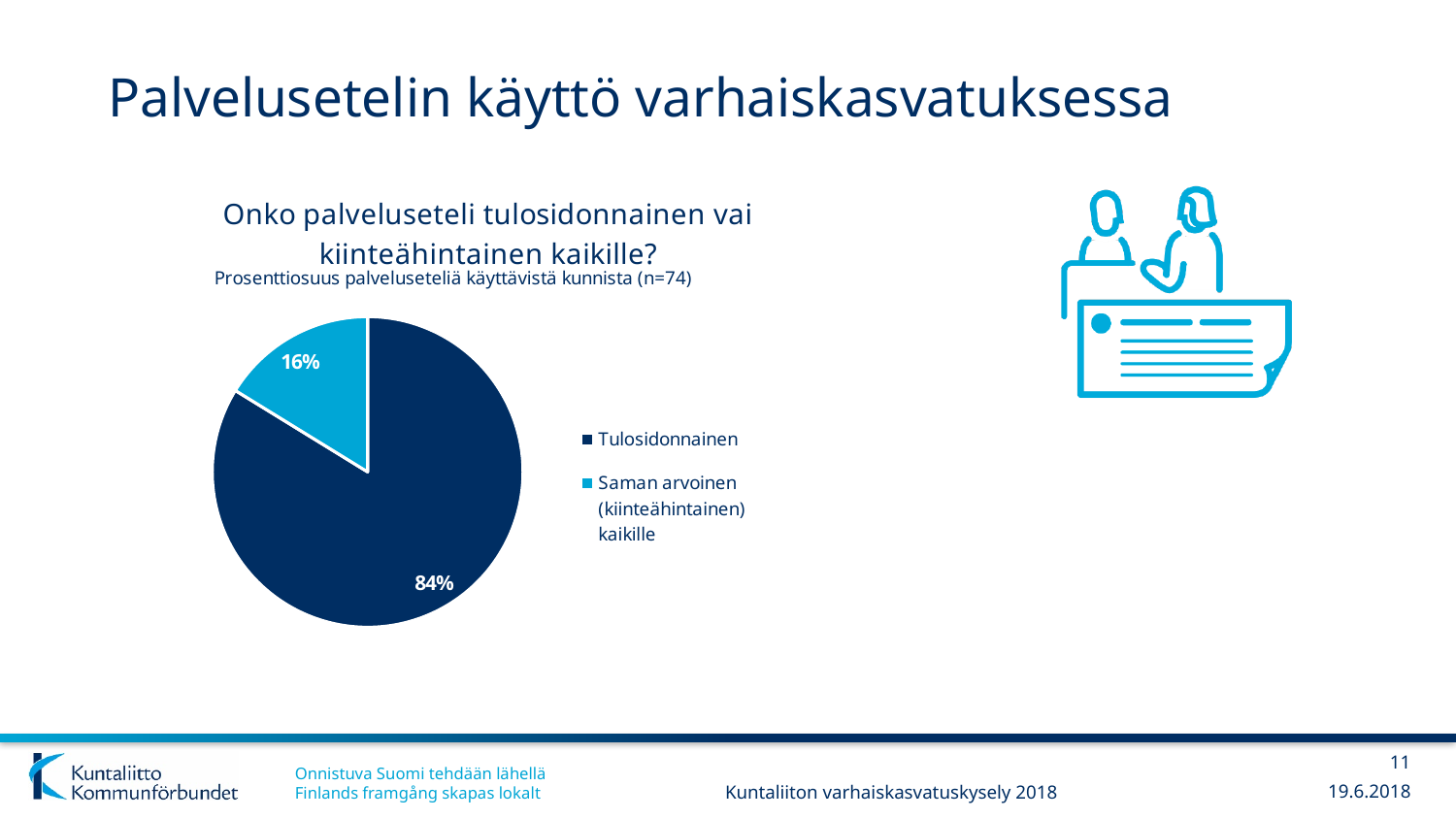
What percentage of the pie is labelled Tulosidonnainen? 84% How many municipalities (n) does the chart subtitle say the percentages are based on? 74 What kind of chart is shown on the slide? Pie chart How many entries does the legend list? 2 What percentage of the pie is labelled Saman arvoinen (kiinteähintainen) kaikille? 16% What is the difference in percentage points between the Tulosidonnainen slice and the Saman arvoinen (kiinteähintainen) kaikille slice? 68 percentage points Which is larger: the Tulosidonnainen slice or the Saman arvoinen (kiinteähintainen) kaikille slice? Tulosidonnainen Which category has the largest share of the pie? Tulosidonnainen How many slices does the pie chart have? 2 What is the total of the two percentages shown on the pie chart? 100% What is the title of the pie chart? Onko palveluseteli tulosidonnainen vai kiinteähintainen kaikille? Which category has the smallest share of the pie? Saman arvoinen (kiinteähintainen) kaikille